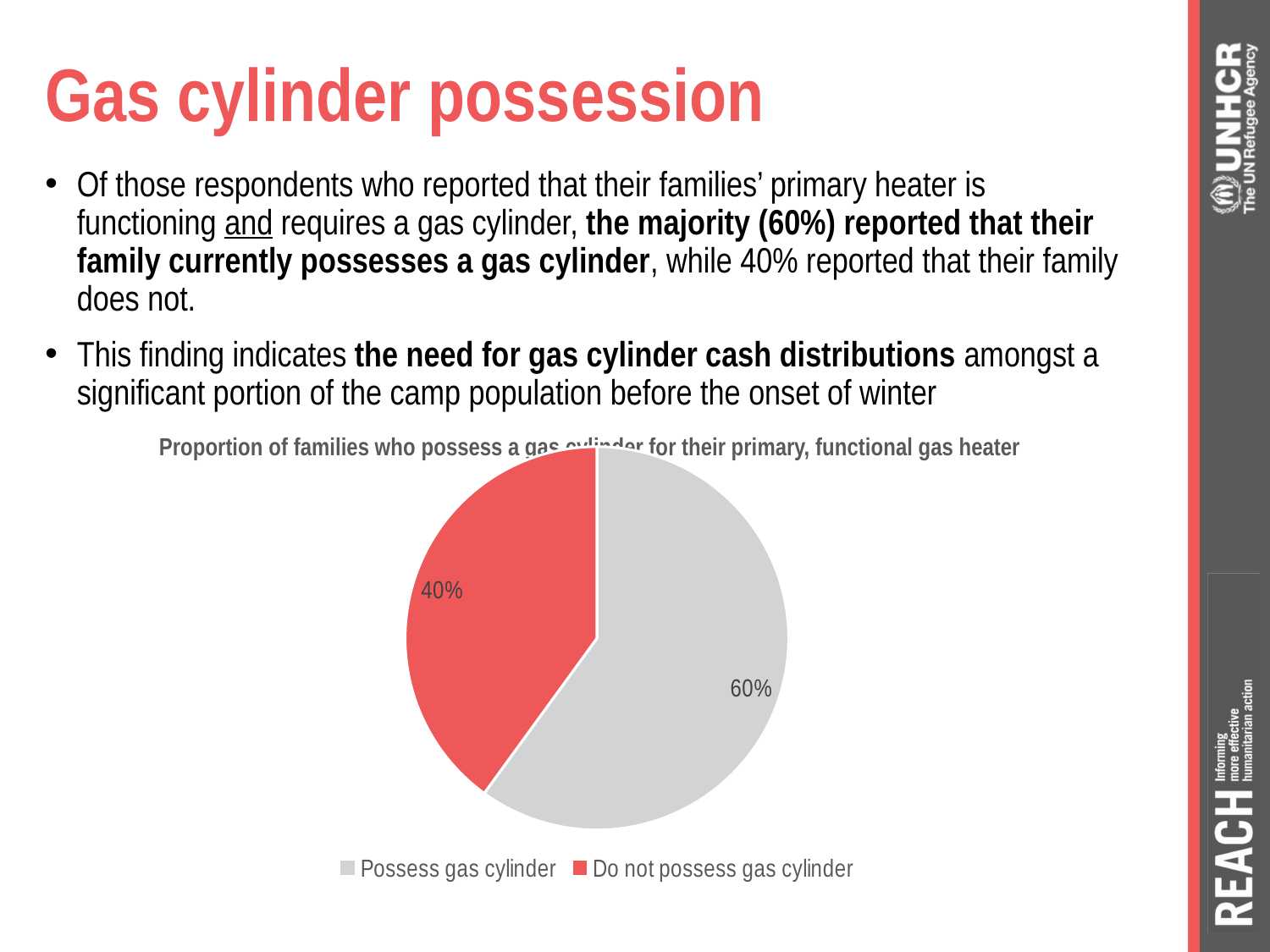
What is the difference in percentage points between the share that possess a gas cylinder and the share that do not? 20 percentage points How many slices does the pie chart have? 2 What kind of chart is shown on the slide? pie chart Which slice of the pie is the largest? Possess gas cylinder Which is larger: the share that possess a gas cylinder or the share that do not? Possess gas cylinder What share of families possess a gas cylinder? 60% How many entries does the legend list? 2 Which slice of the pie is the smallest? Do not possess gas cylinder What colour is the slice for families who do not possess a gas cylinder? red What is the title of the pie chart? Proportion of families who possess a gas cylinder for their primary, functional gas heater Is the share of families who possess a gas cylinder greater or less than 50%? greater What share of families do not possess a gas cylinder? 40%